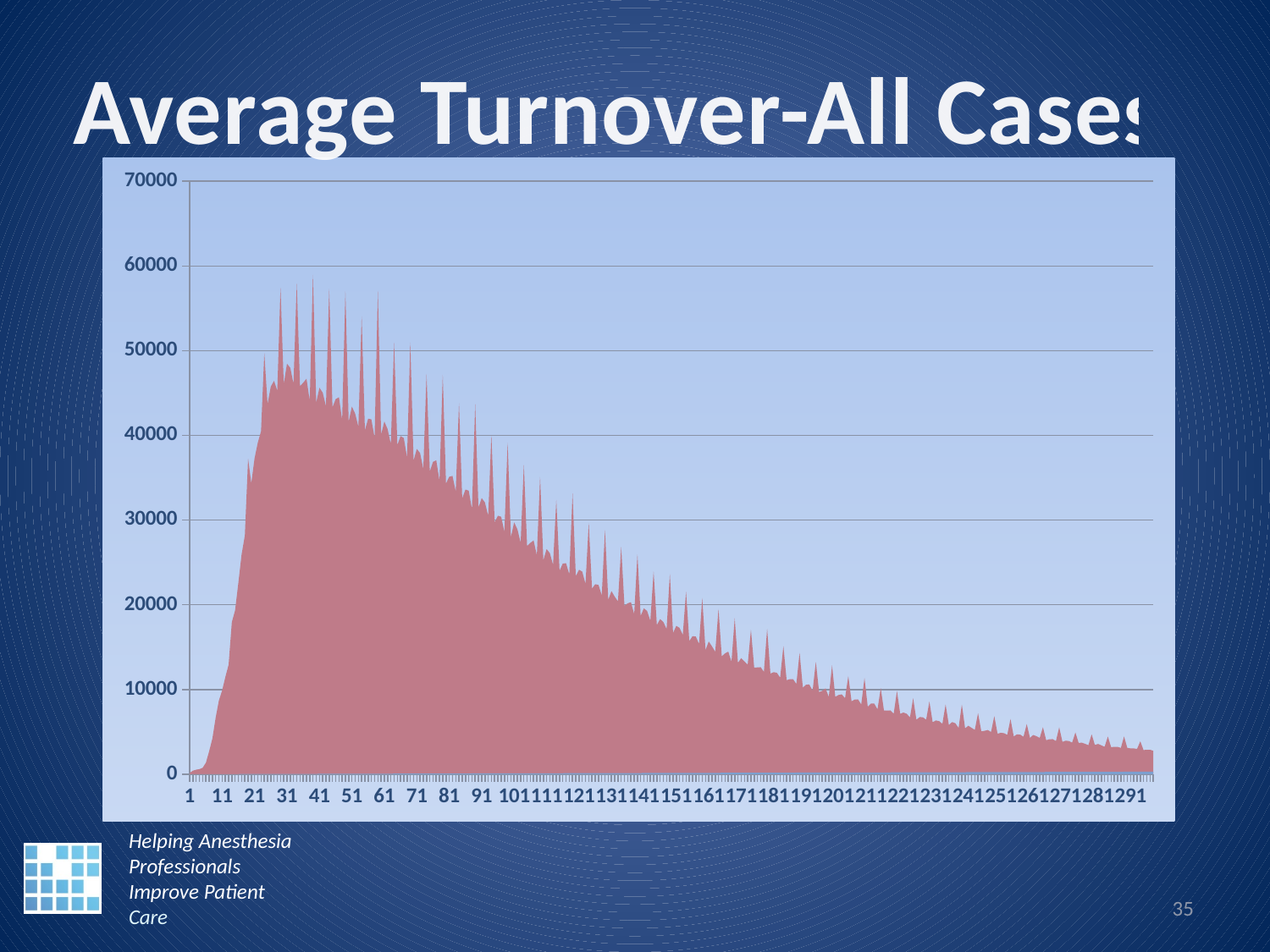
Is the value at x = 41 greater or less than 30000? greater Is the highest value in the chart greater or less than 50000? greater Is the value at x = 291 greater or less than 10000? less What is the title of the chart? Average Turnover-All Cases What kind of chart is shown on the slide? Area chart What is the highest value shown on the y axis? 70000 Do the values rise or fall along the x axis from 41 to 291? fall Is the value at x = 41 larger or smaller than the value at x = 241? larger